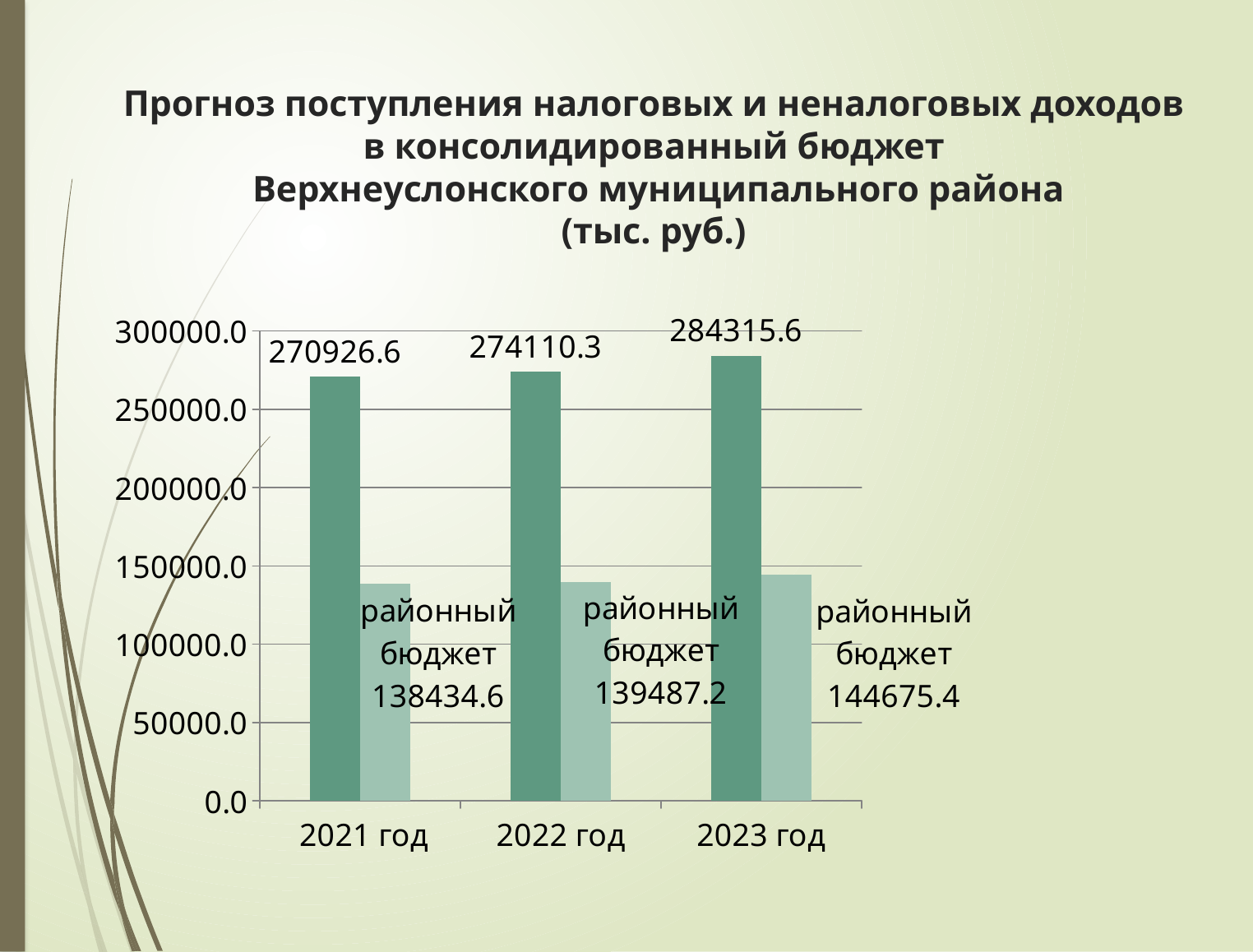
What value is labelled on the dark green bar for 2021 год? 270926.6 What is the difference between the dark green bar values for 2023 год and 2021 год? 13389.0 Do the dark green bar values rise or fall from 2021 год to 2023 год? Rise Which is larger: the районный бюджет value for 2022 год or for 2023 год? 2023 год What value is labelled on the dark green bar for 2023 год? 284315.6 How many years are shown on the x axis? 3 In which year is the районный бюджет value the lowest? 2021 год What is the районный бюджет value for 2023 год? 144675.4 What is the difference between the районный бюджет values for 2023 год and 2021 год? 6240.8 What is the районный бюджет value for 2022 год? 139487.2 What kind of chart is shown on the slide? Bar chart In which year is the dark green bar the highest? 2023 год